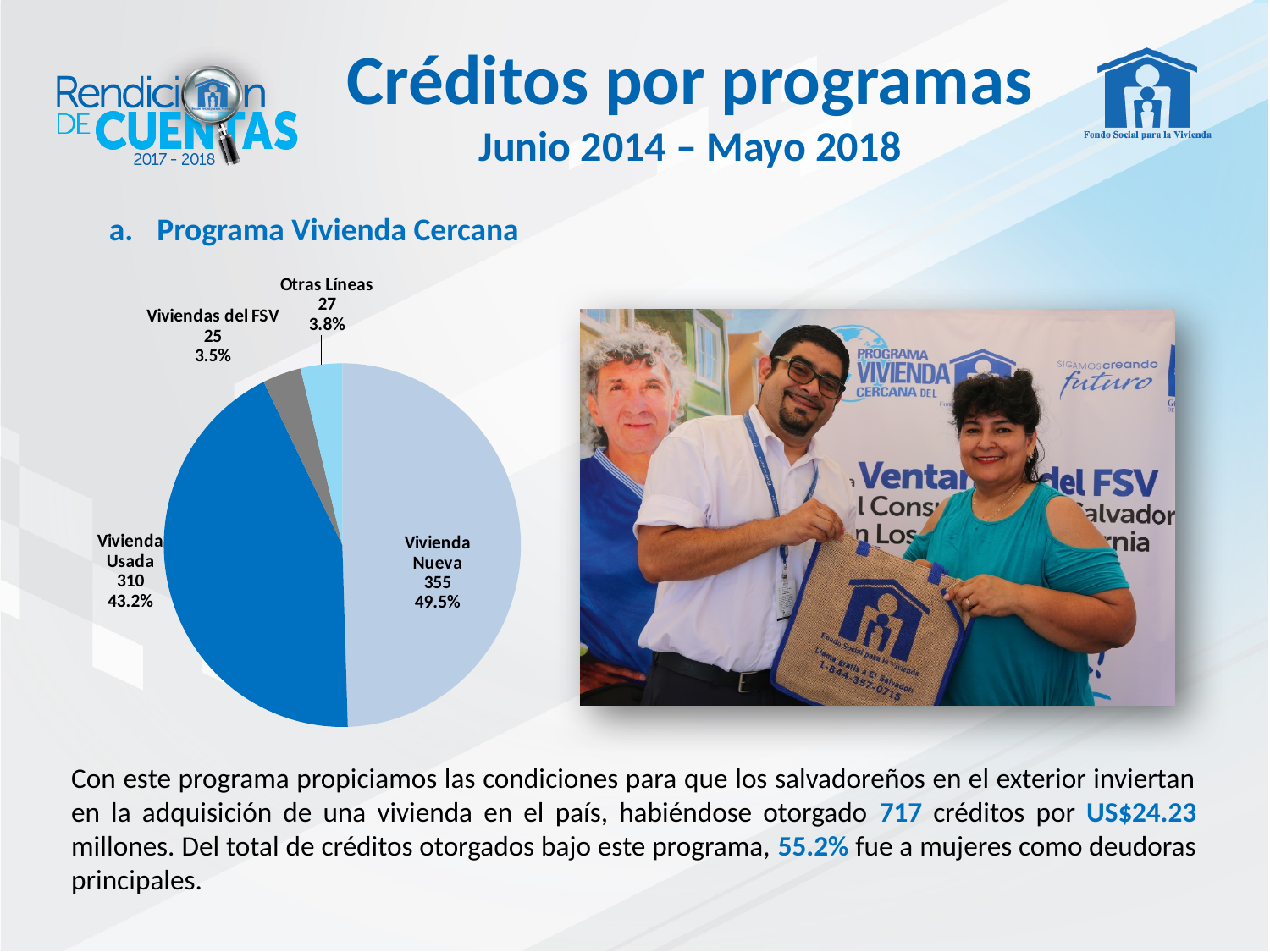
What is the title of the program the pie chart refers to? Programa Vivienda Cercana What is the total number of credits across all four slices of the pie? 717 What percentage share does Vivienda Usada have? 43.2% What percentage share does Otras Líneas have? 3.8% Which category has the largest slice of the pie? Vivienda Nueva What kind of chart is shown on the slide? pie chart What is the difference in credits between Vivienda Nueva and Vivienda Usada? 45 Which category has the smallest slice of the pie? Viviendas del FSV How many credits are shown for Viviendas del FSV? 25 Which has more credits, Otras Líneas or Viviendas del FSV? Otras Líneas How many credits are shown for Vivienda Nueva? 355 How many categories does the pie chart show? 4